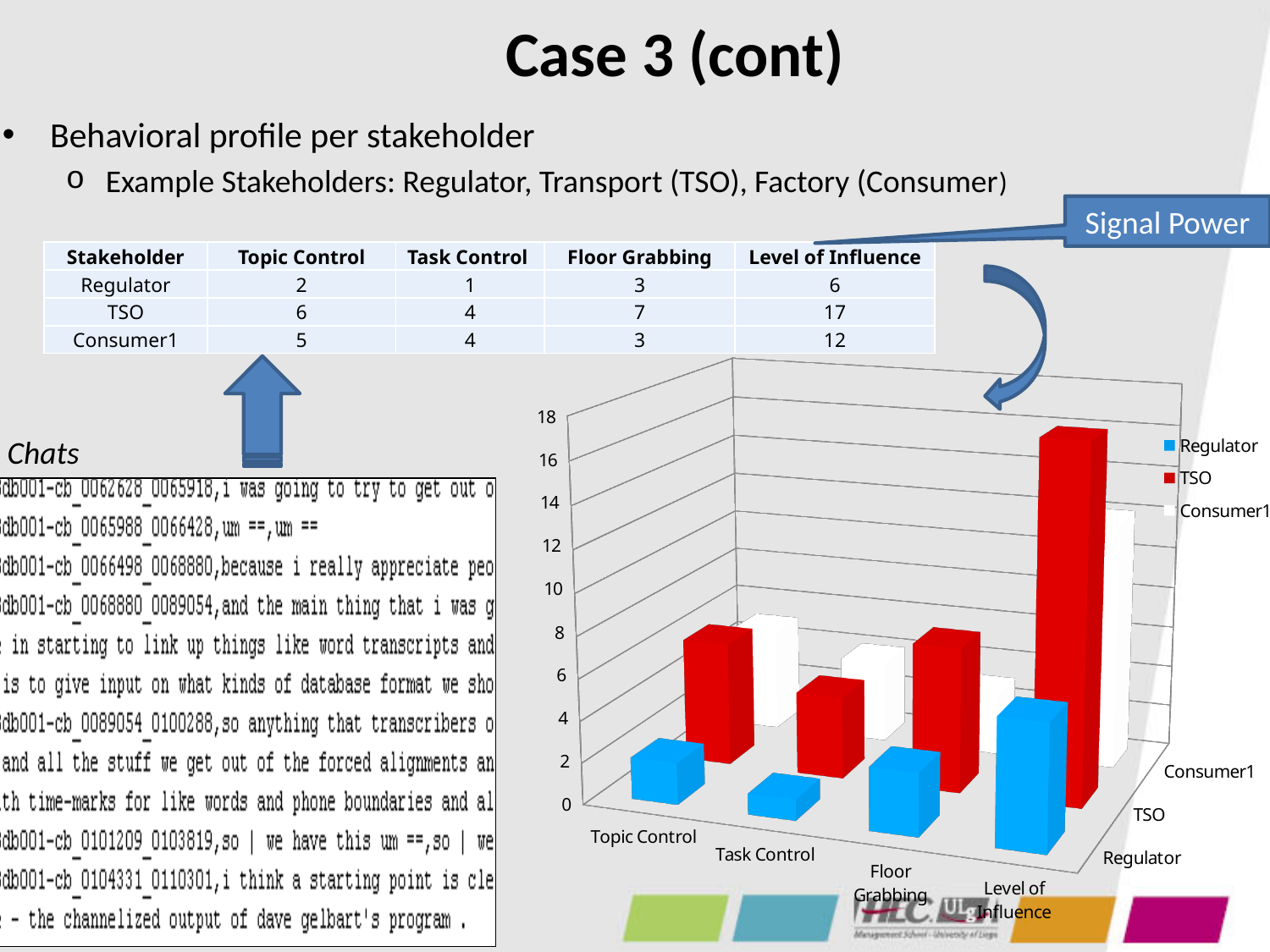
For Topic Control, which is larger: the TSO bar or the Regulator bar? TSO Is the TSO bar for Floor Grabbing greater or less than 4? greater Is the TSO bar for Level of Influence greater or less than 14? greater For Level of Influence, which is larger: the TSO bar or the Consumer1 bar? TSO Which series and category has the tallest bar in the chart? TSO, Level of Influence How many categories are shown along the x axis of the chart? 4 Which series has the shortest bar for Task Control? Regulator What kind of chart is shown on the slide? bar chart How many series does the chart's legend list? 3 Is the Regulator bar for Task Control greater or less than 2? less What colour are the TSO bars in the chart? red What is the highest value shown on the chart's vertical axis? 18